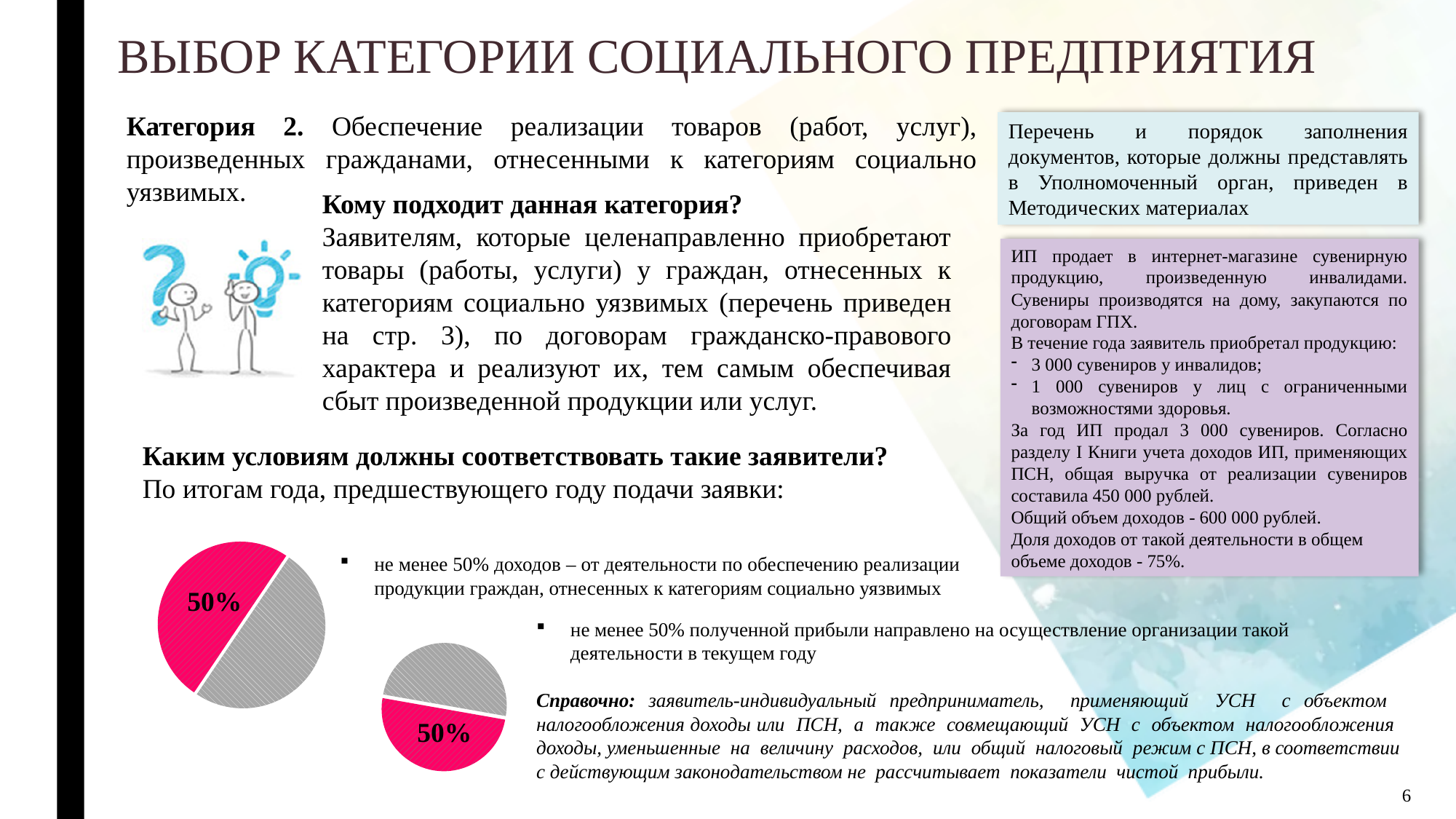
In the smaller pie chart near the bottom centre, what share of the pie does the pink slice represent? 50% In the larger pie chart at the bottom left, what share of the pie does the pink slice represent? 50% How many slices does the smaller pie chart near the bottom centre have? 2 In the larger pie chart at the bottom left, what value is printed on the pink slice? 50% In the smaller pie chart near the bottom centre, what value is printed on the pink slice? 50% What kind of chart is the larger chart at the bottom left of the slide? pie chart How many pie charts are shown on the slide? 2 How many slices does the larger pie chart at the bottom left have? 2 What kind of chart is the smaller chart near the bottom centre of the slide? pie chart In the larger pie chart at the bottom left, what colour is the slice that carries the 50% label? pink